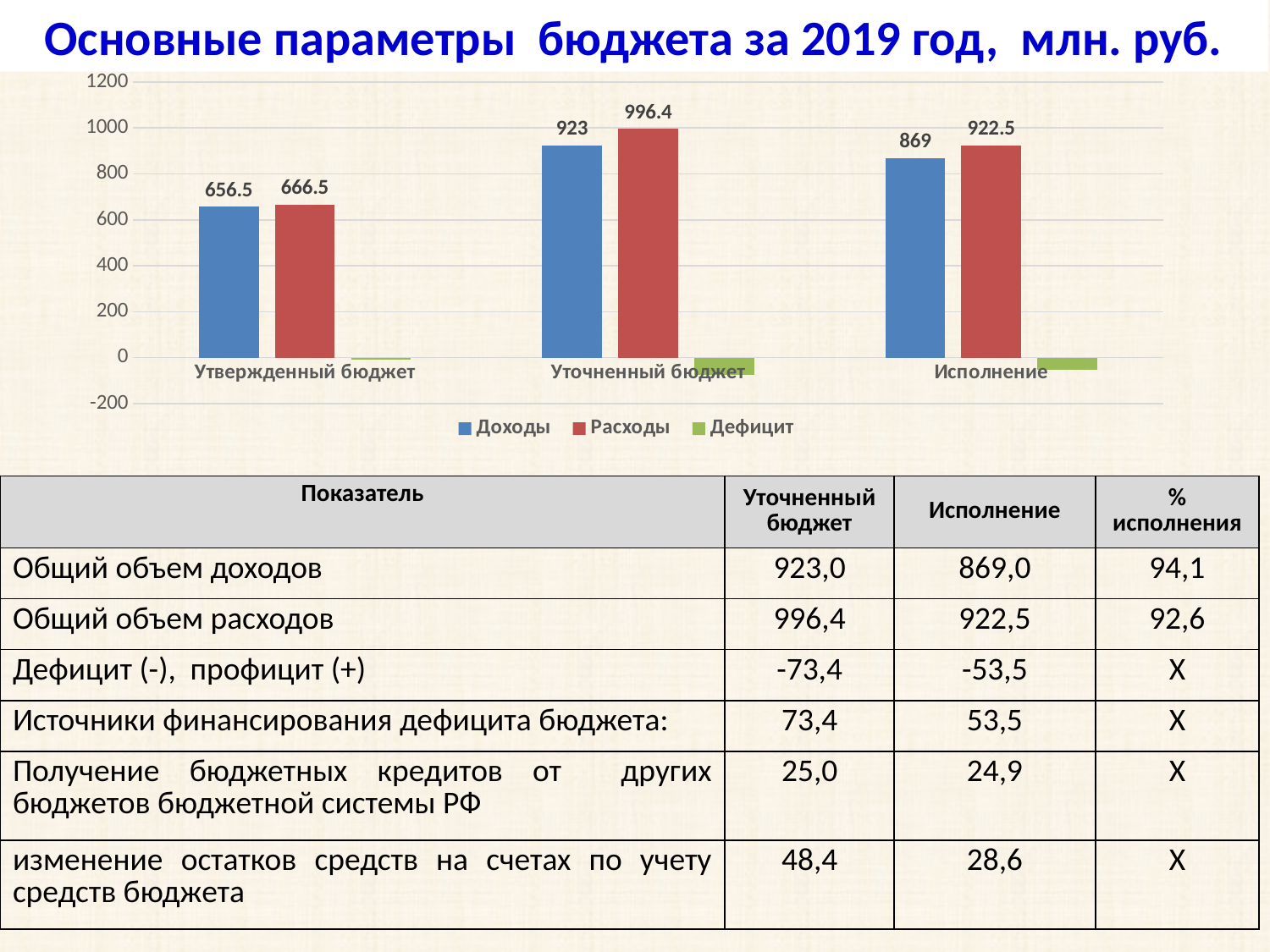
What is the value of Доходы for Утвержденный бюджет? 656.5 Which category has the lowest value for Доходы? Утвержденный бюджет Which category has the highest value for Расходы? Уточненный бюджет What is the value of Доходы for Исполнение? 869 Which is larger: Доходы for Уточненный бюджет or Доходы for Исполнение? Уточненный бюджет What is the difference between Расходы and Доходы for Исполнение? 53.5 What is the difference between Расходы and Доходы for Уточненный бюджет? 73.4 What is the value of Расходы for Уточненный бюджет? 996.4 How many series does the chart legend list? 3 Is the value of Дефицит for Уточненный бюджет greater or less than 0? less What is the value of Расходы for Исполнение? 922.5 How many categories are shown on the x axis of the chart? 3